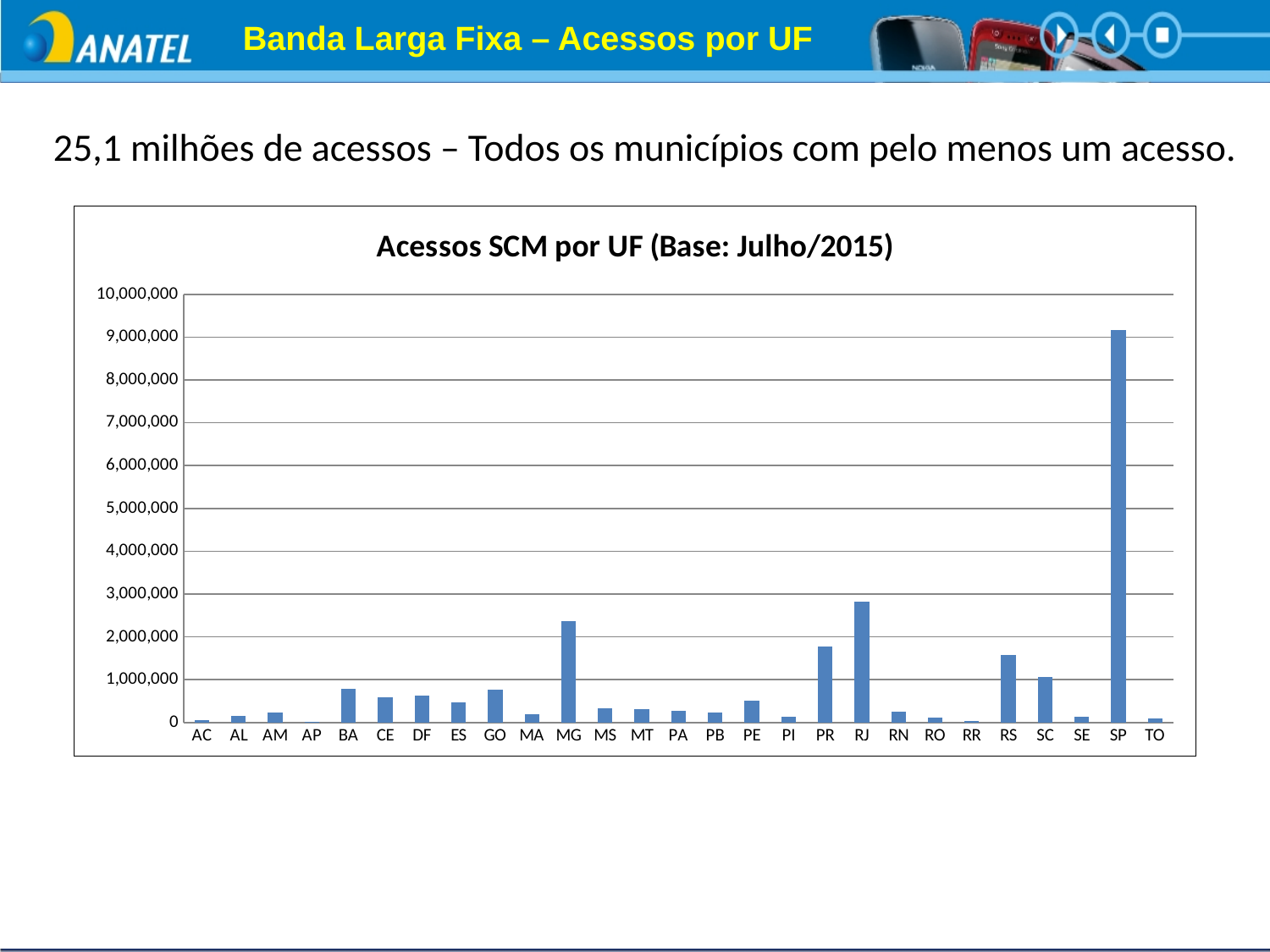
What kind of chart is shown on the slide? bar chart Is the value for BA greater or less than 1,000,000? less How many UFs (categories) are shown on the x axis of the chart? 27 Is the value for RS greater or less than 1,000,000? greater Is the value for MG greater or less than 2,000,000? greater What is the maximum value shown on the vertical axis of the chart? 10,000,000 Which UF has the highest number of accesses in the chart? SP Which has more accesses, RJ or MG? RJ What is the title of the chart? Acessos SCM por UF (Base: Julho/2015)